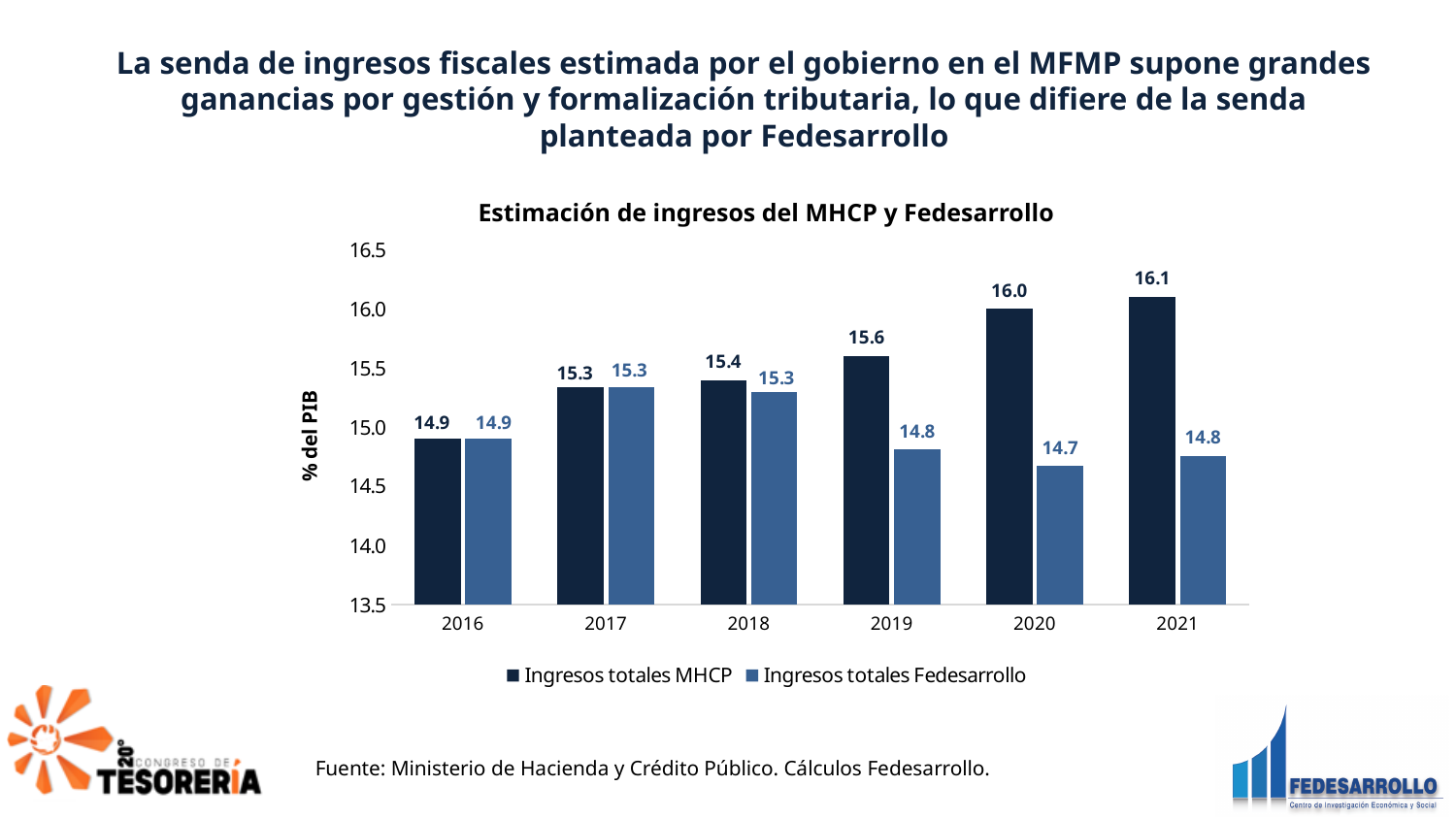
Which is larger in 2019: Ingresos totales MHCP or Ingresos totales Fedesarrollo? Ingresos totales MHCP Which year has the lowest value for Ingresos totales Fedesarrollo? 2020 What is the value for Ingresos totales Fedesarrollo in 2020? 14.7 What is the difference between Ingresos totales MHCP and Ingresos totales Fedesarrollo in 2020? 1.3 What kind of chart is shown? Bar chart What is the value for Ingresos totales MHCP in 2021? 16.1 Do the values for Ingresos totales MHCP rise or fall from 2016 to 2021? Rise How many series does the legend list? 2 Which year has the highest value for Ingresos totales MHCP? 2021 What is the value for Ingresos totales MHCP in 2019? 15.6 How many years are shown on the x axis? 6 What is the title of the chart? Estimación de ingresos del MHCP y Fedesarrollo